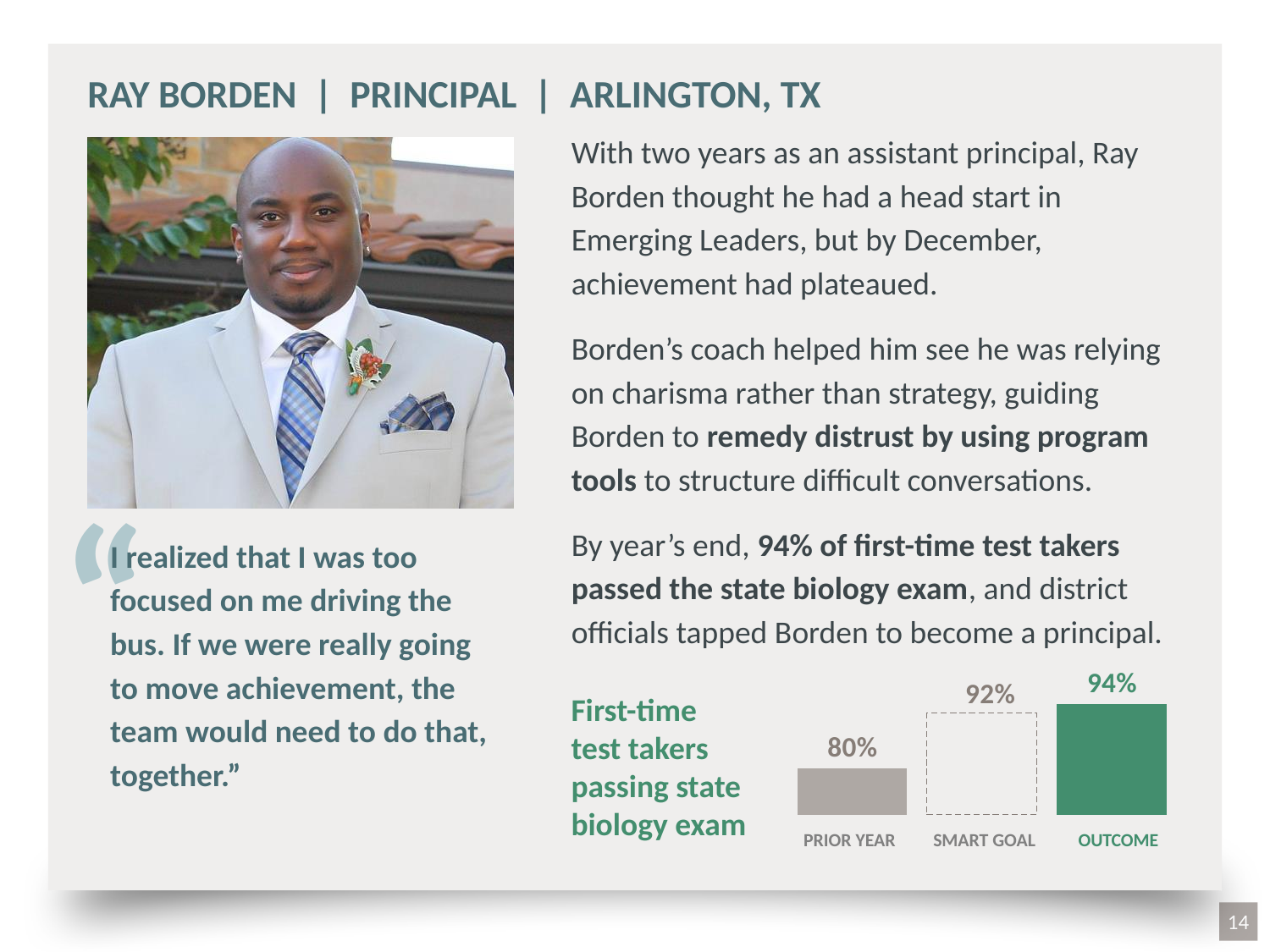
How many categories are shown in the chart? 3 What is the value for OUTCOME in the chart? 94% What is the value for SMART GOAL in the chart? 92% Do the values rise or fall from PRIOR YEAR to OUTCOME? rise Which category has the highest value in the chart? OUTCOME What is the difference between the OUTCOME and PRIOR YEAR values? 14% Which is larger, the SMART GOAL value or the PRIOR YEAR value? SMART GOAL What is the value for PRIOR YEAR in the chart? 80% What is the difference between the OUTCOME and SMART GOAL values? 2% What does the chart measure, according to its label? First-time test takers passing state biology exam Which category has the lowest value in the chart? PRIOR YEAR What kind of chart is shown on the slide? bar chart